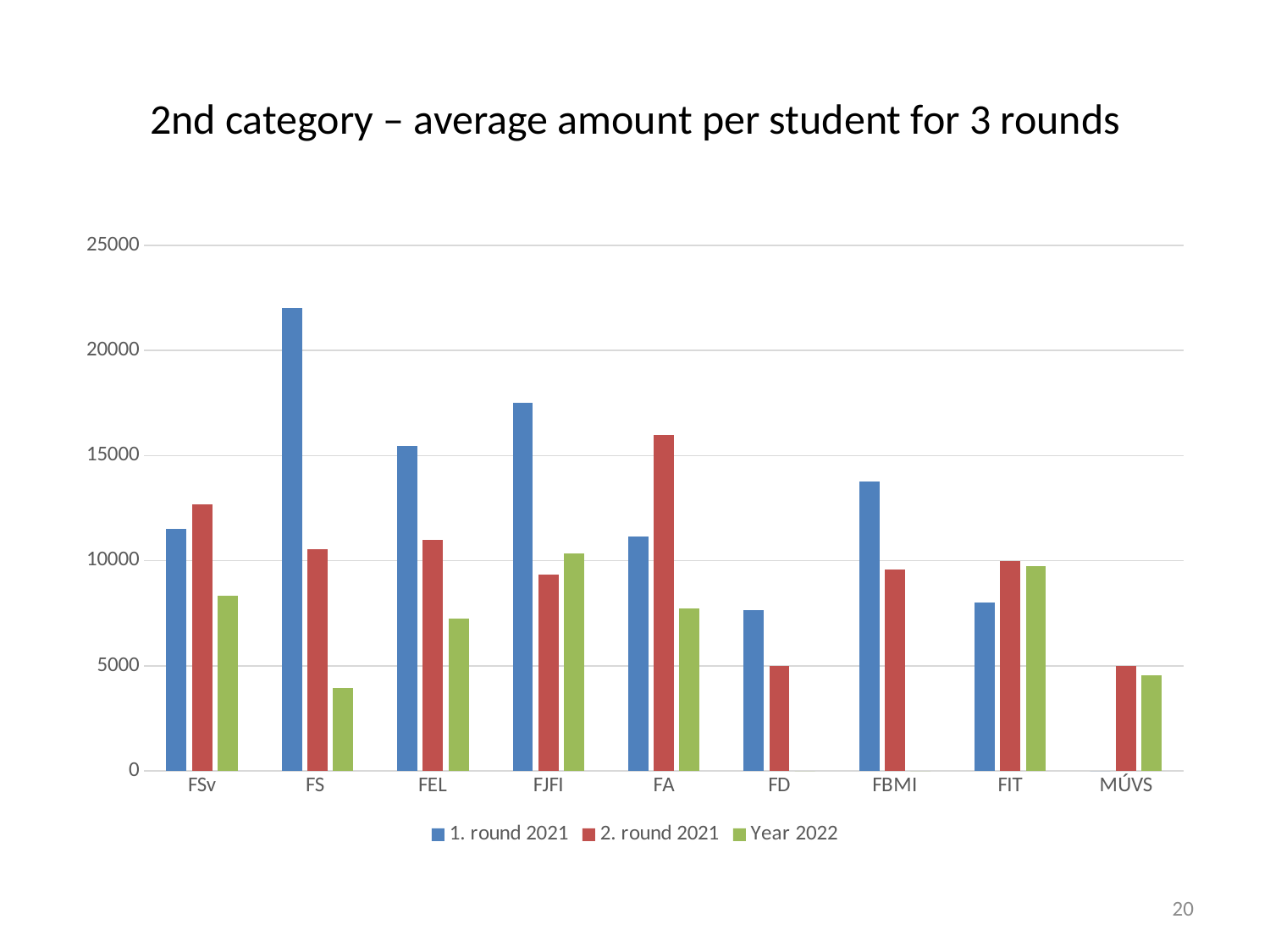
For FA, which is larger: the 1. round 2021 value or the 2. round 2021 value? 2. round 2021 For FEL, which is larger: the 1. round 2021 value or the 2. round 2021 value? 1. round 2021 How many categories are shown on the x axis? 9 Which category has no bar for 1. round 2021? MÚVS Is the 1. round 2021 value for FS greater or less than 20000? greater Which category has the highest value for 2. round 2021? FA Is the 1. round 2021 value for FBMI greater or less than 15000? less What kind of chart is shown on the slide? bar chart Which category has the highest value for 1. round 2021? FS Is the 1. round 2021 value for FJFI greater or less than 15000? greater How many series does the legend list? 3